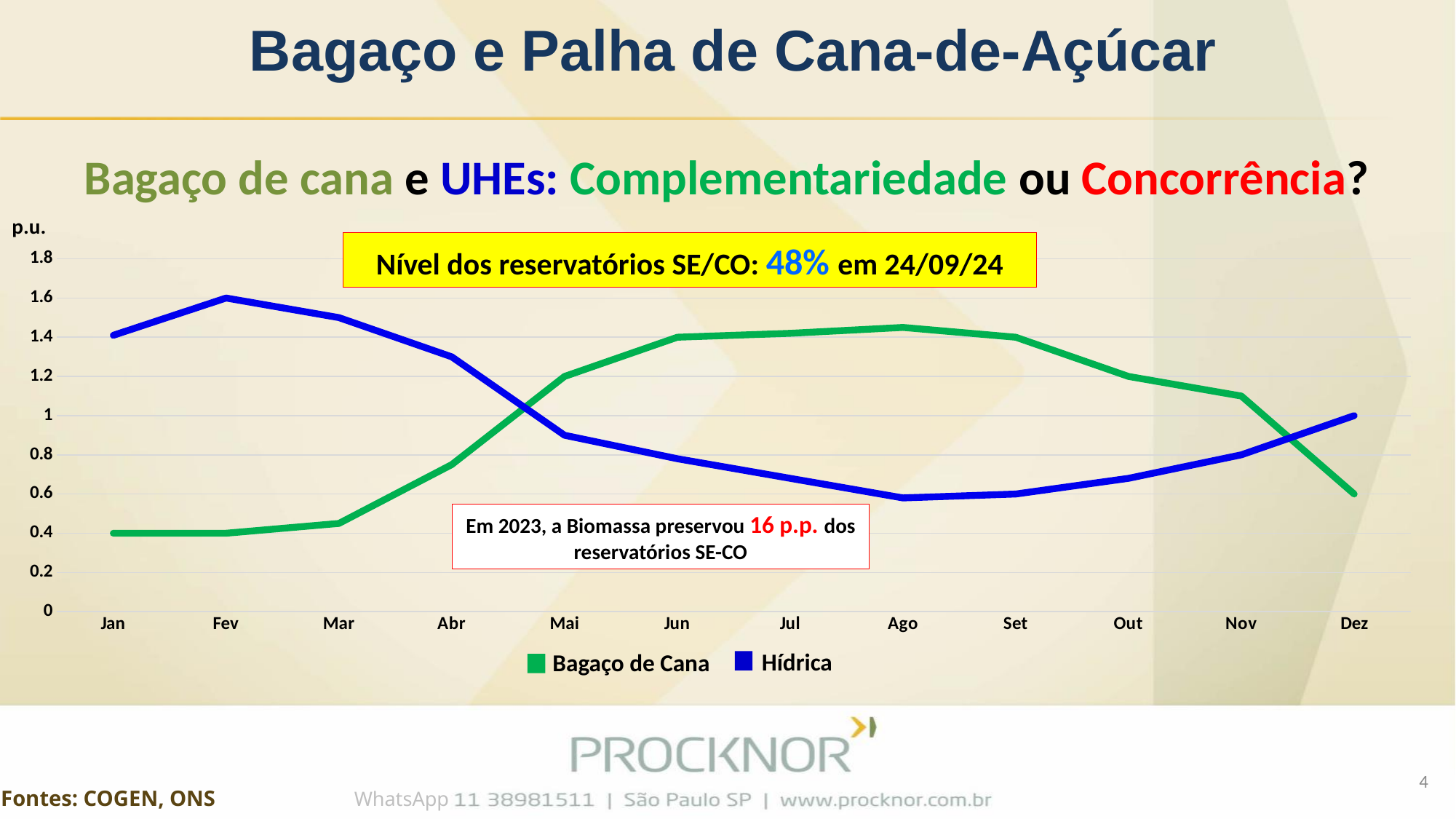
Is the value for Bagaço de Cana in Abr greater or less than 0.8? less What kind of chart is shown on the slide? line chart In Ago, which series has the larger value, Bagaço de Cana or Hídrica? Bagaço de Cana Does the Hídrica series rise or fall from Fev to Ago? fall In Jan, which series has the larger value, Bagaço de Cana or Hídrica? Hídrica How many series does the chart legend list? 2 How many months are plotted along the x axis? 12 What is the value of Bagaço de Cana in Jun? 1.4 What is the value of Hídrica in Dez? 1 In which month is the Hídrica series at its highest? Fev What is the value of Hídrica in Fev? 1.6 What unit is shown at the top of the y axis? p.u.